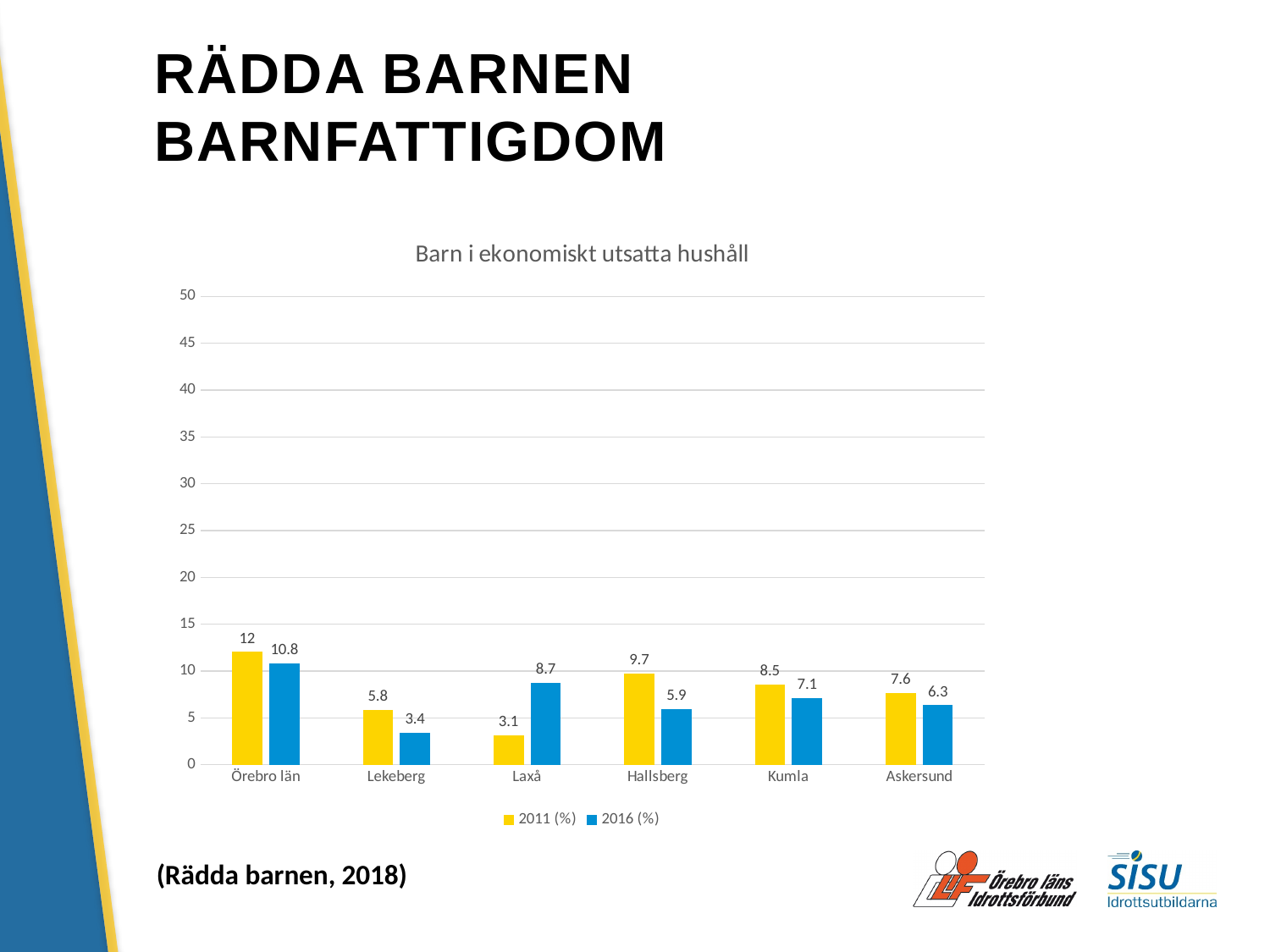
Is the 2011 (%) value for Hallsberg greater or less than 5? greater Which category has the lowest 2016 (%) value? Lekeberg What is the 2016 (%) value for Hallsberg? 5.9 Which category has the highest 2011 (%) value? Örebro län Which is larger for Laxå: the 2011 (%) value or the 2016 (%) value? 2016 (%) How many categories are shown on the x axis? 6 What is the 2011 (%) value for Örebro län? 12 What is the title of the chart? Barn i ekonomiskt utsatta hushåll What kind of chart is shown on the slide? Bar chart What is the 2016 (%) value for Laxå? 8.7 How many series does the legend list? 2 What is the difference between the 2011 (%) and 2016 (%) values for Kumla? 1.4